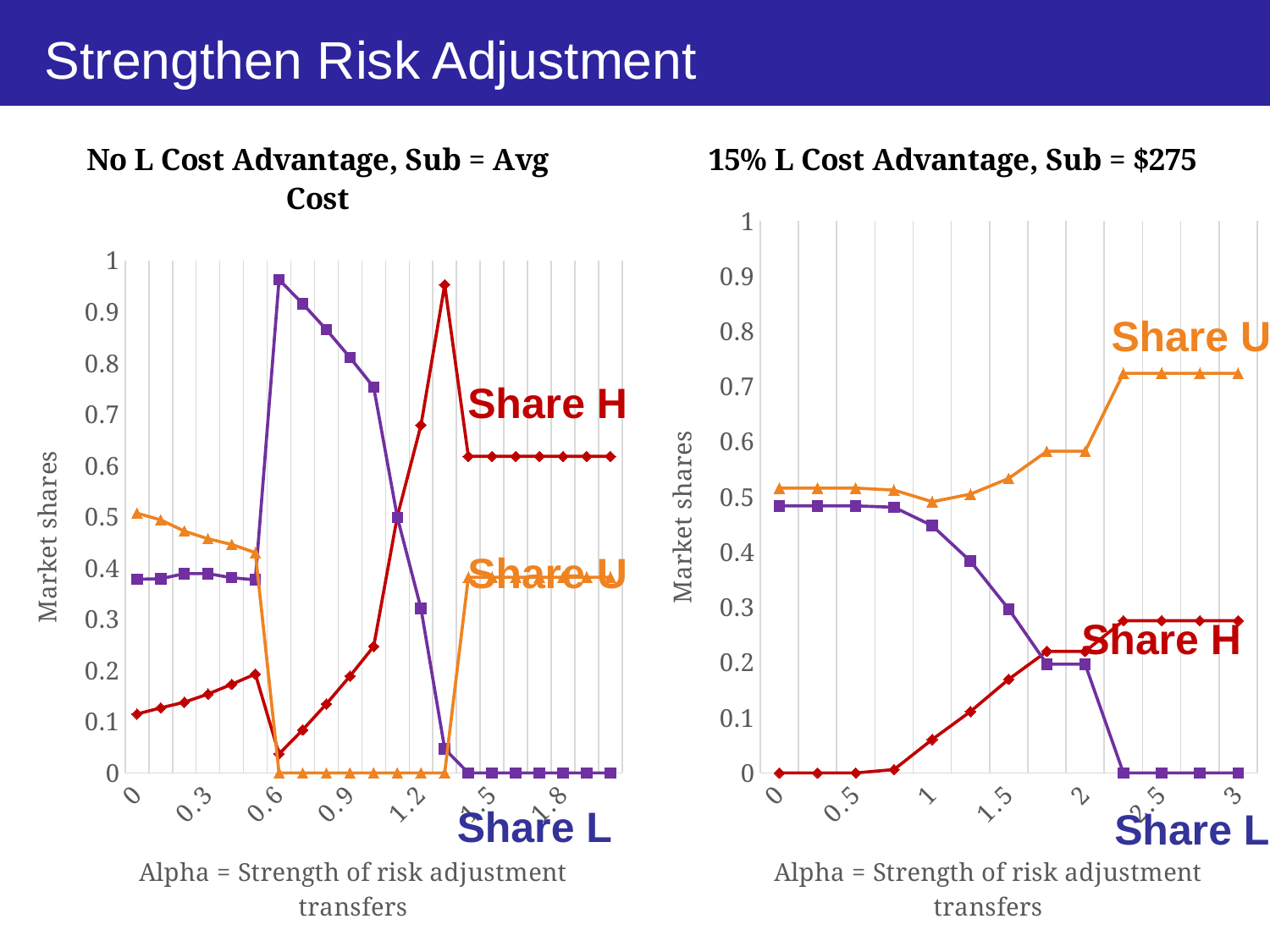
What kind of chart is the left chart titled "No L Cost Advantage, Sub = Avg Cost"? line chart In the right chart (15% L Cost Advantage, Sub = $275), is the value of Share L at alpha = 1.5 greater or less than 0.4? less In the right chart (15% L Cost Advantage, Sub = $275), what is the value of Share H at alpha = 0? 0 In the left chart (No L Cost Advantage, Sub = Avg Cost), is the value of Share H at alpha = 0 greater or less than 0.2? less In the right chart (15% L Cost Advantage, Sub = $275), does Share L rise or fall as alpha increases from 0 to 3? fall In the left chart (No L Cost Advantage, Sub = Avg Cost), is the value of Share L at alpha = 0.6 greater or less than 0.9? greater What is the label on the vertical axis of the left chart? Market shares In the right chart (15% L Cost Advantage, Sub = $275), what is the value of Share L at alpha = 3? 0 In the right chart (15% L Cost Advantage, Sub = $275), which series has the highest value at alpha = 3? Share U In the left chart (No L Cost Advantage, Sub = Avg Cost), what is the value of Share L at alpha = 1.8? 0 How many series are plotted in the right chart titled "15% L Cost Advantage, Sub = $275"? 3